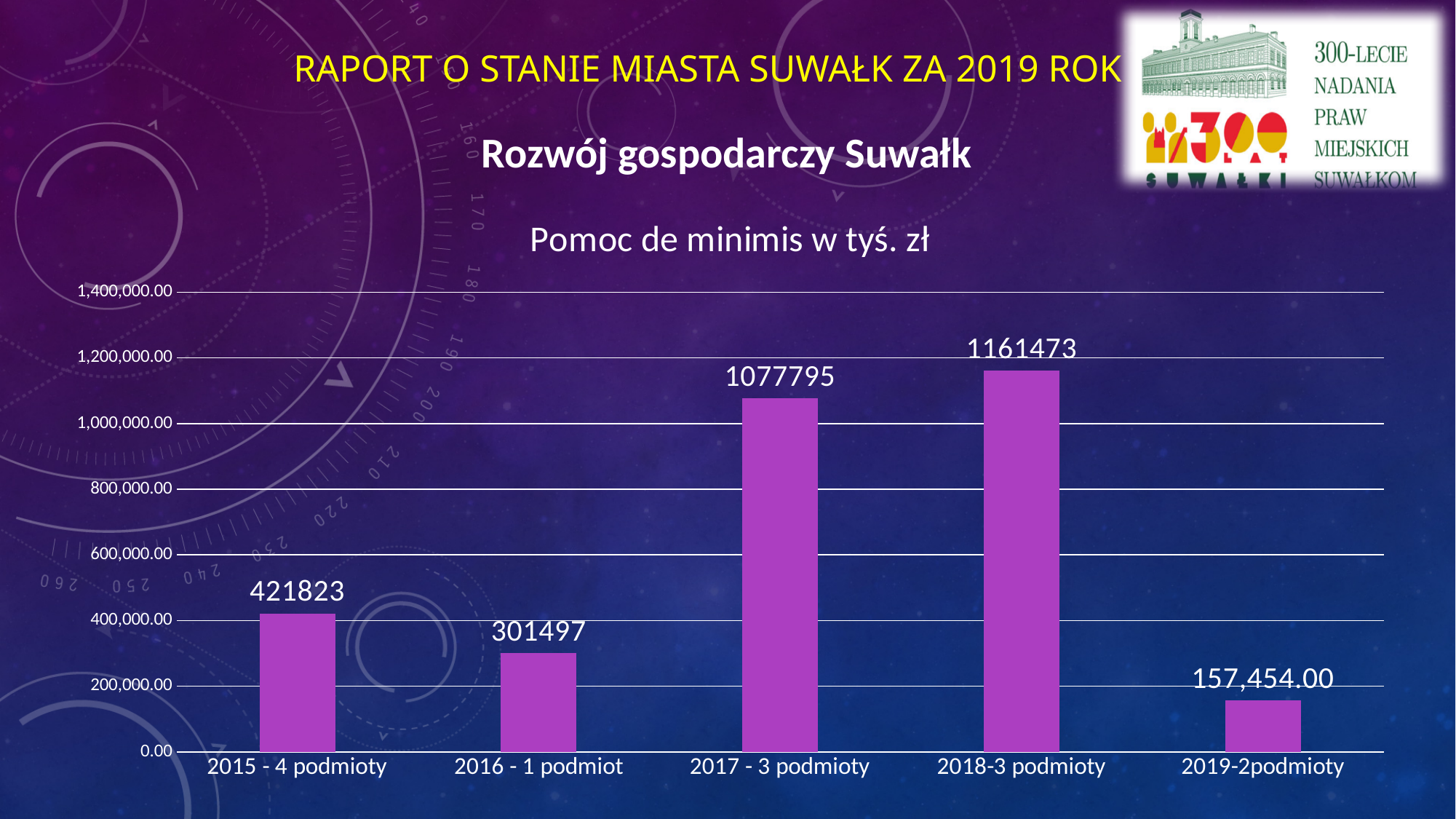
Which category has the highest value? 2018-3 podmioty What is the value shown for 2017 - 3 podmioty? 1077795 Is the value for 2017 - 3 podmioty greater or less than 1,000,000.00? greater What is the value shown for 2019-2podmioty? 157,454.00 What is the title of the chart? Pomoc de minimis w tyś. zł What is the difference between the values for 2015 - 4 podmioty and 2016 - 1 podmiot? 120326 Which category has the lowest value? 2019-2podmioty What kind of chart is shown on the slide? bar chart What is the value shown for 2015 - 4 podmioty? 421823 What is the difference between the values for 2018-3 podmioty and 2017 - 3 podmioty? 83678 How many categories are shown on the x axis? 5 Which is larger, the value for 2016 - 1 podmiot or the value for 2019-2podmioty? 2016 - 1 podmiot